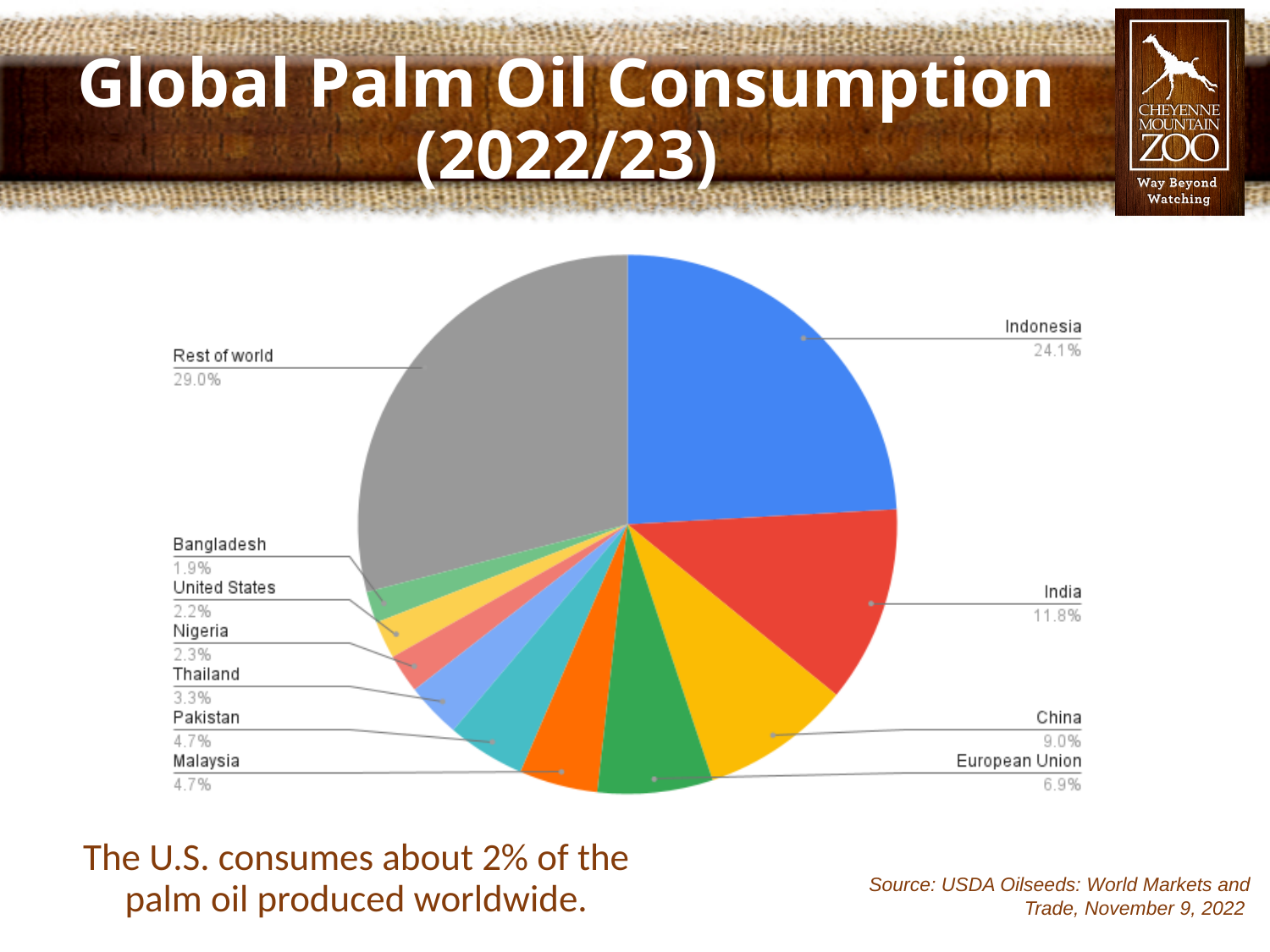
What percentage is shown for India? 11.8% What kind of chart is shown on the slide? Pie chart What is the difference between Indonesia's share and India's share? 12.3% Which slice of the pie is the largest? Rest of world What is the title of the slide containing the chart? Global Palm Oil Consumption (2022/23) What share of global palm oil consumption does Indonesia account for? 24.1% What percentage is shown for the United States? 2.2% Which has a larger share, China or the European Union? China How many slices does the pie chart have? 11 Which named country has the smallest share? Bangladesh What is the value shown for the European Union? 6.9% What is the combined share of Malaysia and Pakistan? 9.4%